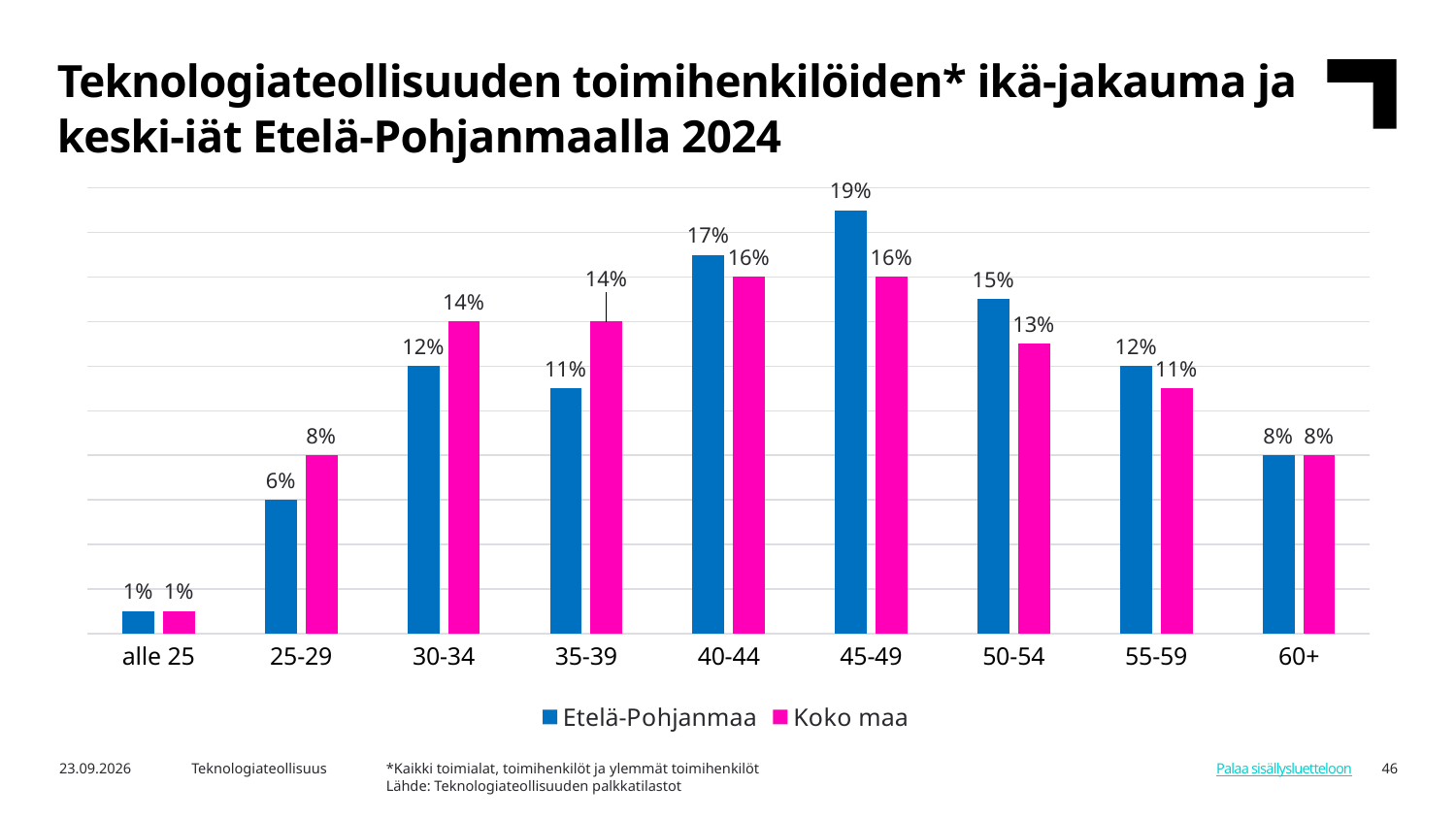
Do the Etelä-Pohjanmaa values rise or fall from the 45-49 age group to the 60+ age group? Fall What is the difference between the Etelä-Pohjanmaa and Koko maa values in the 35-39 age group? 3 percentage points How many series does the legend list? 2 How many age groups are shown on the x axis? 9 What kind of chart is shown on the slide? Bar chart Which age group has the highest value for Etelä-Pohjanmaa? 45-49 What is the value for Etelä-Pohjanmaa in the 25-29 age group? 6% Which age group has the lowest value for Koko maa? alle 25 Which colour represents Koko maa in the chart? Pink What is the value for Koko maa in the 30-34 age group? 14% What is the value for Etelä-Pohjanmaa in the 45-49 age group? 19% In the 50-54 age group, which series has the larger value, Etelä-Pohjanmaa or Koko maa? Etelä-Pohjanmaa